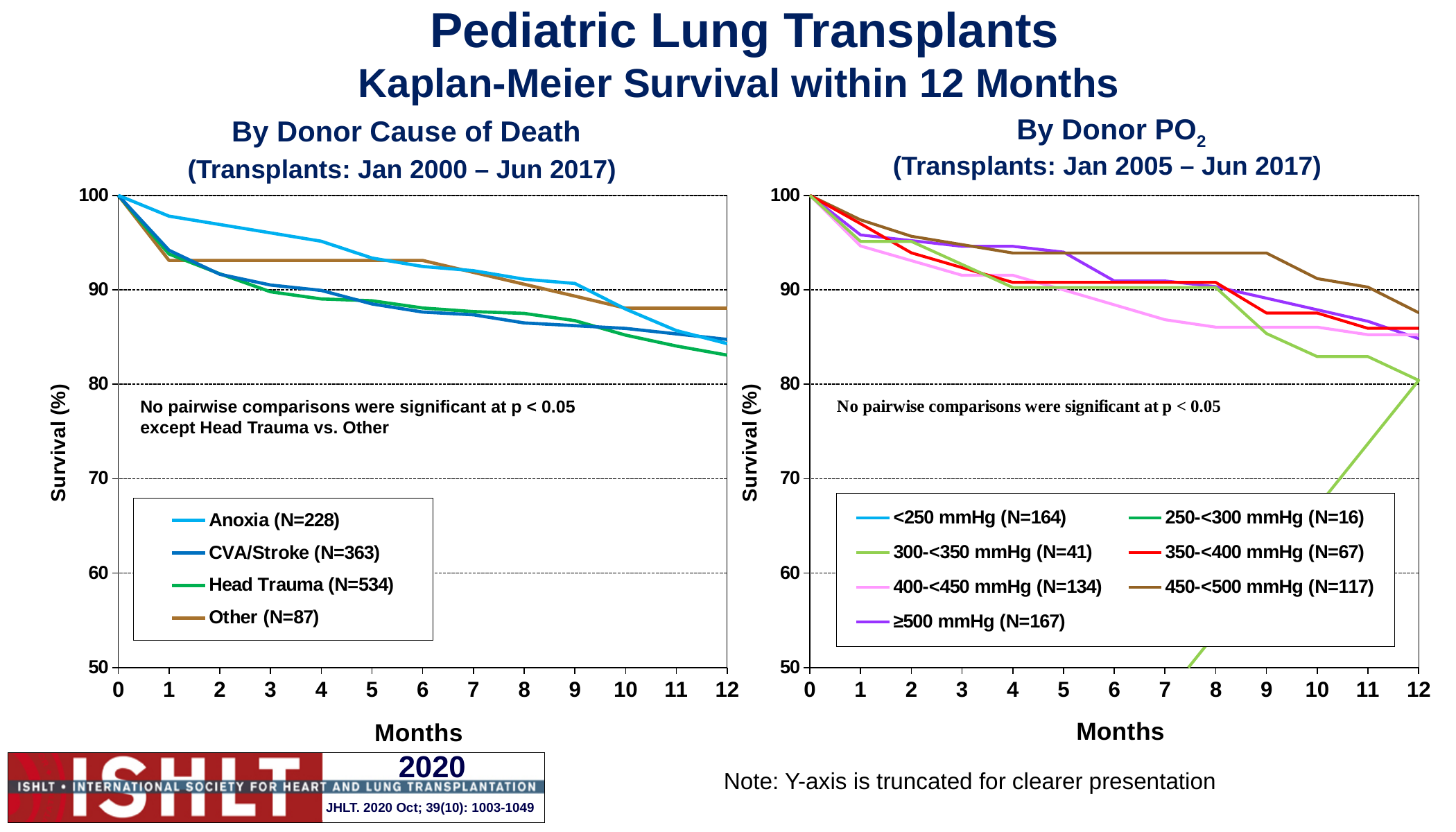
In the left chart, 'By Donor Cause of Death', which is higher at 12 months, Other or Head Trauma? Other In the left chart, 'By Donor Cause of Death', what is the N for the Head Trauma series shown in the legend? 534 In the left chart, 'By Donor Cause of Death', is the survival value for Head Trauma at 12 months greater or less than 80? greater In the right chart, 'By Donor PO2', is the survival value for 300-<350 mmHg at 10 months greater or less than 90? less How many series does the legend of the left chart, 'By Donor Cause of Death', list? 4 In the right chart, 'By Donor PO2', is the survival value for 450-<500 mmHg at 9 months greater or less than 90? greater In the right chart, 'By Donor PO2', which series has the lowest survival at 12 months? 300-<350 mmHg (N=41) How many series does the legend of the right chart, 'By Donor PO2', list? 7 What kind of chart is the left chart, 'By Donor Cause of Death'? Line chart In the left chart, 'By Donor Cause of Death', which series has the highest survival at 12 months? Other (N=87) In the left chart, 'By Donor Cause of Death', do the survival curves rise or fall as months increase? Fall